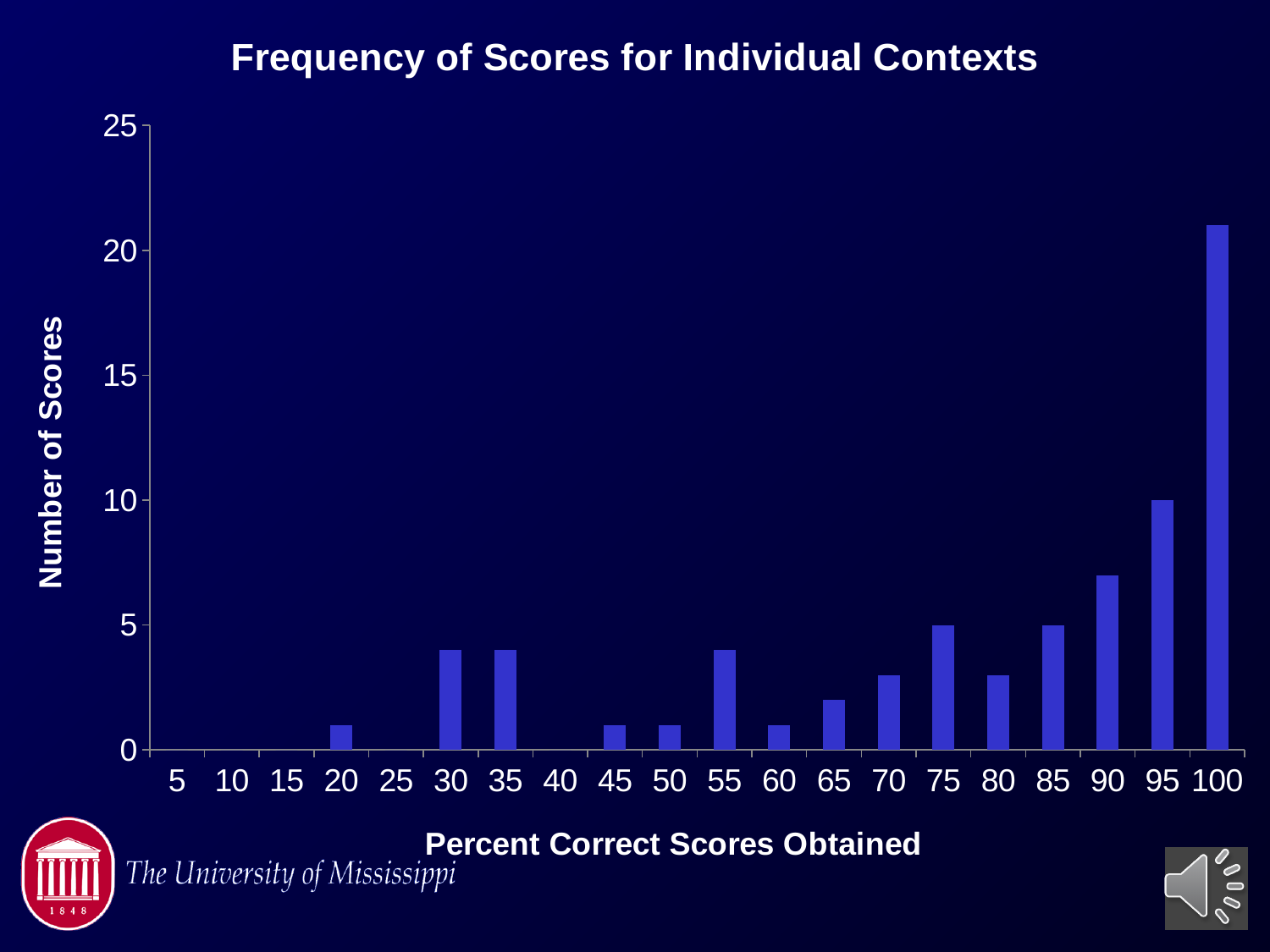
What is the title of the chart? Frequency of Scores for Individual Contexts What is the label of the y axis? Number of Scores Which percent correct score category has the highest number of scores? 100 Which has more scores, the 95 or the 90 percent correct category? 95 Is the number of scores for the 65 percent correct category greater or less than 5? less What kind of chart is shown on the slide? bar chart Is the number of scores for the 100 percent correct category greater or less than 20? greater What is the number of scores for the 85 percent correct category? 5 Is the number of scores for the 90 percent correct category greater or less than 5? greater What is the number of scores for the 95 percent correct category? 10 What is the number of scores for the 75 percent correct category? 5 What is the difference in number of scores between the 95 and 75 percent correct categories? 5